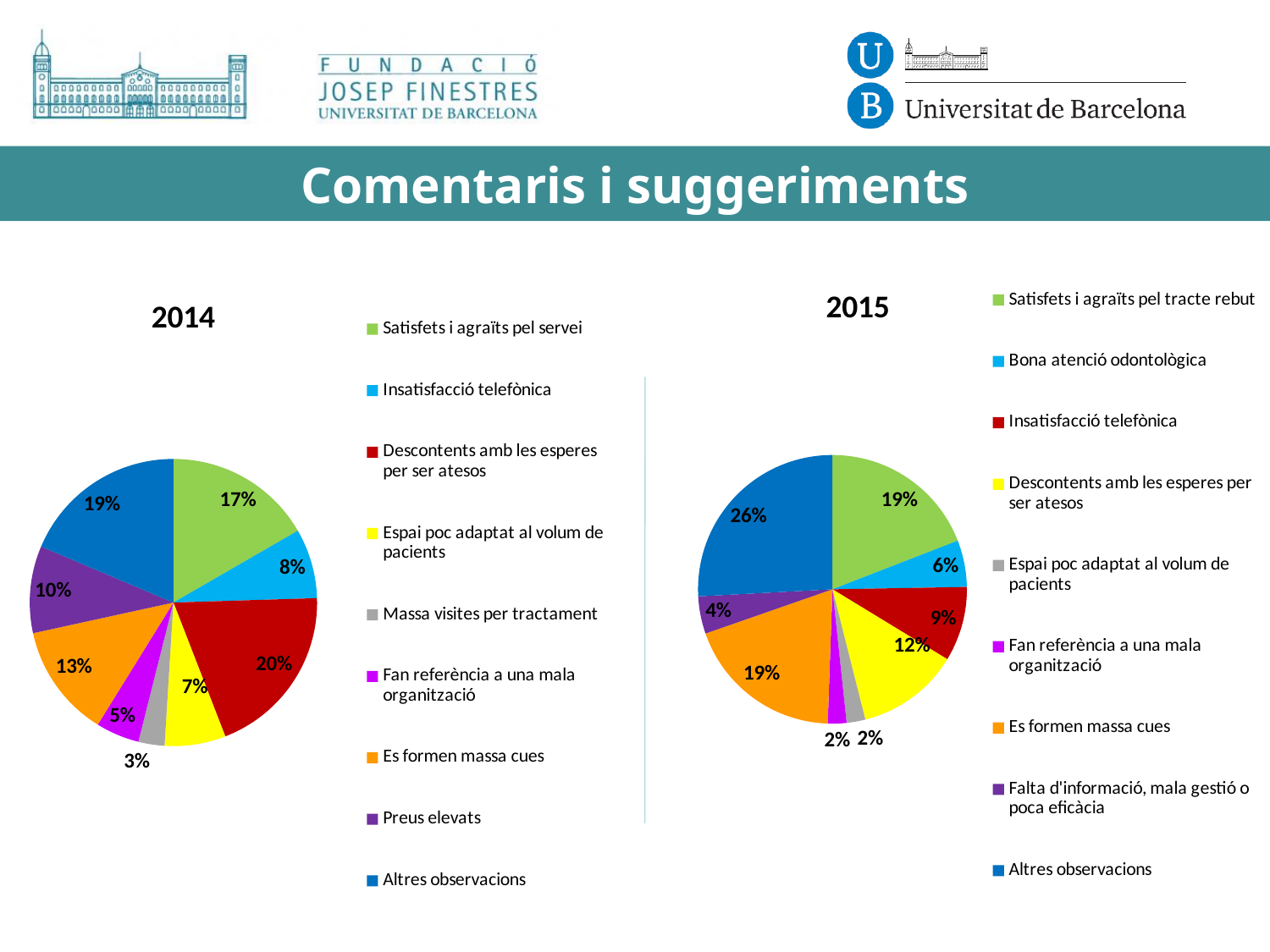
In the 2014 pie chart, what share is labelled for 'Descontents amb les esperes per ser atesos'? 20% In the 2014 pie chart, which category has the smallest slice? Massa visites per tractament In the 2015 pie chart, which category has the largest slice? Altres observacions In the 2015 pie chart, what share is labelled for 'Bona atenció odontològica'? 6% How many categories does the legend of the 2015 pie chart list? 9 What kind of chart is used for the 2014 data? Pie chart In the 2015 pie chart, what share is labelled for 'Altres observacions'? 26% In the 2015 pie chart, what is the difference between the 'Altres observacions' slice and the 'Es formen massa cues' slice? 7% In the 2014 pie chart, which is larger: 'Preus elevats' or 'Insatisfacció telefònica'? Preus elevats In the 2015 pie chart, what colour is the 'Es formen massa cues' slice? Orange In the 2014 pie chart, which category has the largest slice? Descontents amb les esperes per ser atesos In the 2014 pie chart, what share is labelled for 'Es formen massa cues'? 13%